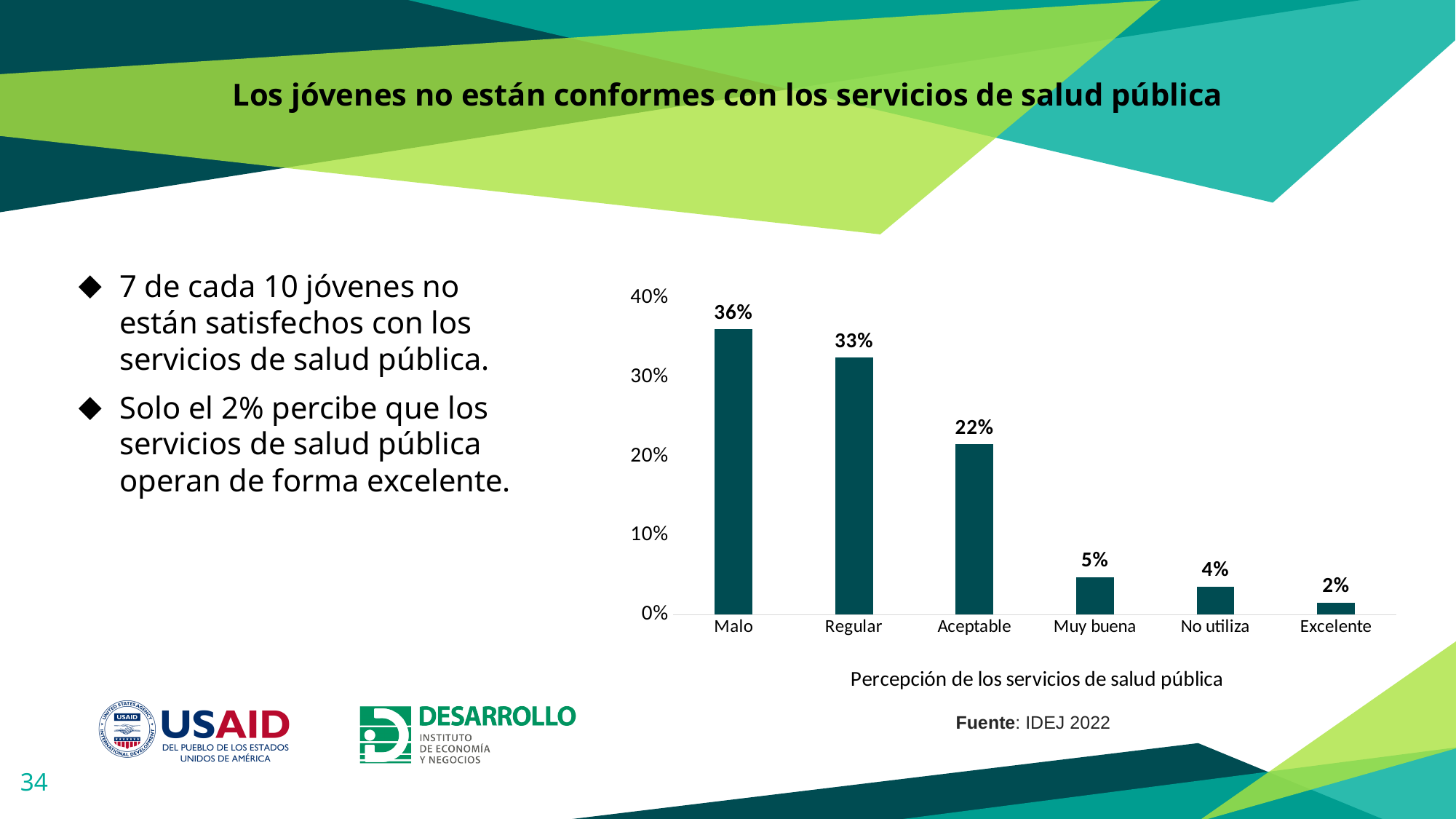
What kind of chart is shown on the slide? bar chart What is the x-axis label of the chart? Percepción de los servicios de salud pública What is the value for No utiliza? 4% Which is larger, the value for Muy buena or the value for No utiliza? Muy buena Which category has the lowest value? Excelente How many categories are shown on the x axis? 6 Which category has the highest value? Malo Is the value for Regular greater or less than 30%? greater What is the difference between the values for Malo and Regular? 3% What is the value for Aceptable? 22% What is the value for Malo? 36% What is the difference between the values for Aceptable and Muy buena? 17%